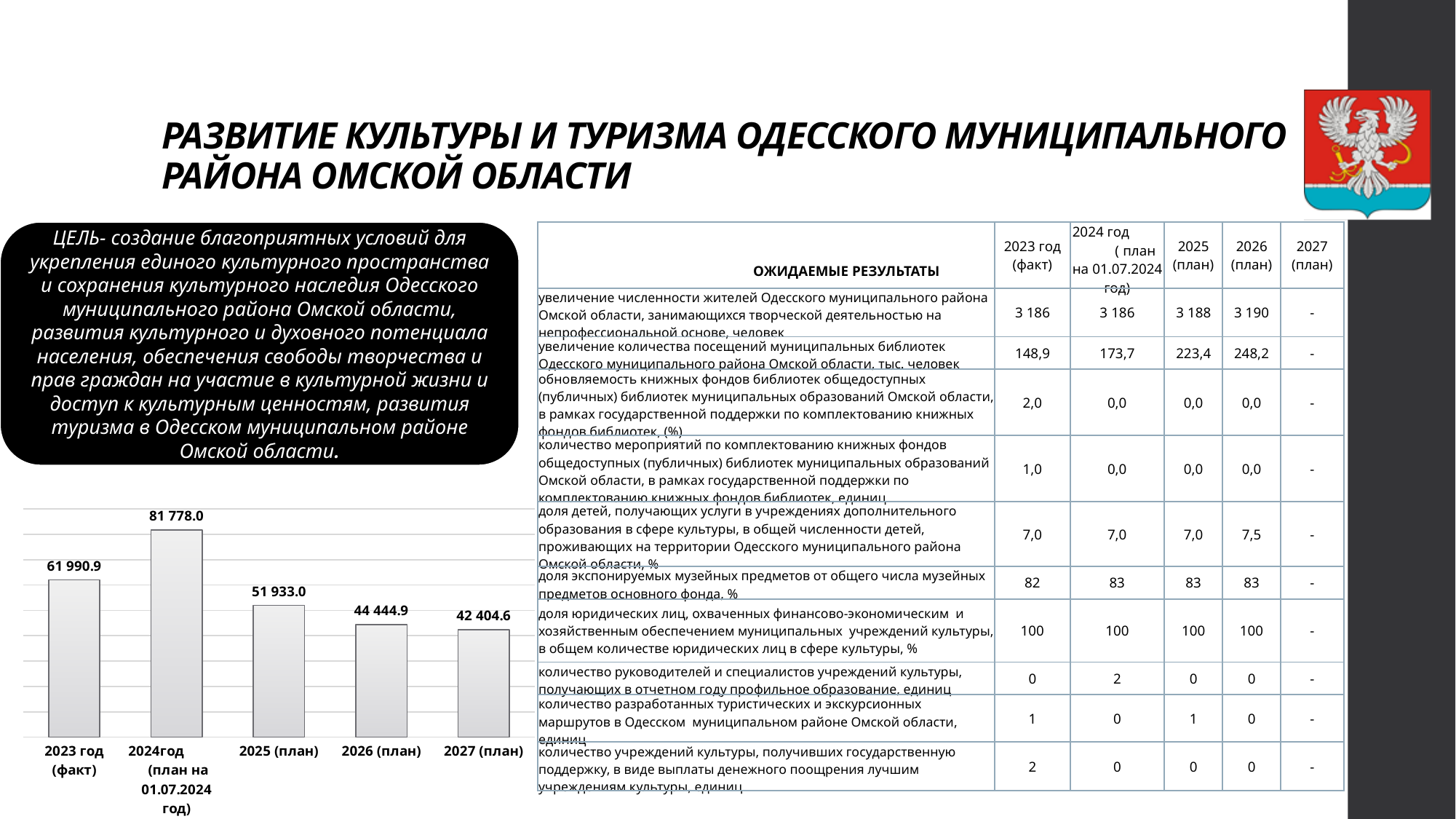
What is the value for 2023 год (факт) in the chart? 61 990.9 What type of chart is shown on the slide? bar chart What is the value for 2024год (план на 01.07.2024 год) in the chart? 81 778.0 Which is larger, the value for 2023 год (факт) or the value for 2025 (план)? 2023 год (факт) Which year has the lowest value in the chart? 2027 (план) How many bars does the chart show? 5 Do the values rise or fall from 2024год (план на 01.07.2024 год) to 2027 (план)? fall What is the value for 2027 (план) in the chart? 42 404.6 Which year has the highest value in the chart? 2024год (план на 01.07.2024 год) What is the difference between the values for 2024год (план на 01.07.2024 год) and 2023 год (факт)? 19 787.1 What is the value for 2025 (план) in the chart? 51 933.0 What is the difference between the values for 2025 (план) and 2026 (план)? 7 488.1